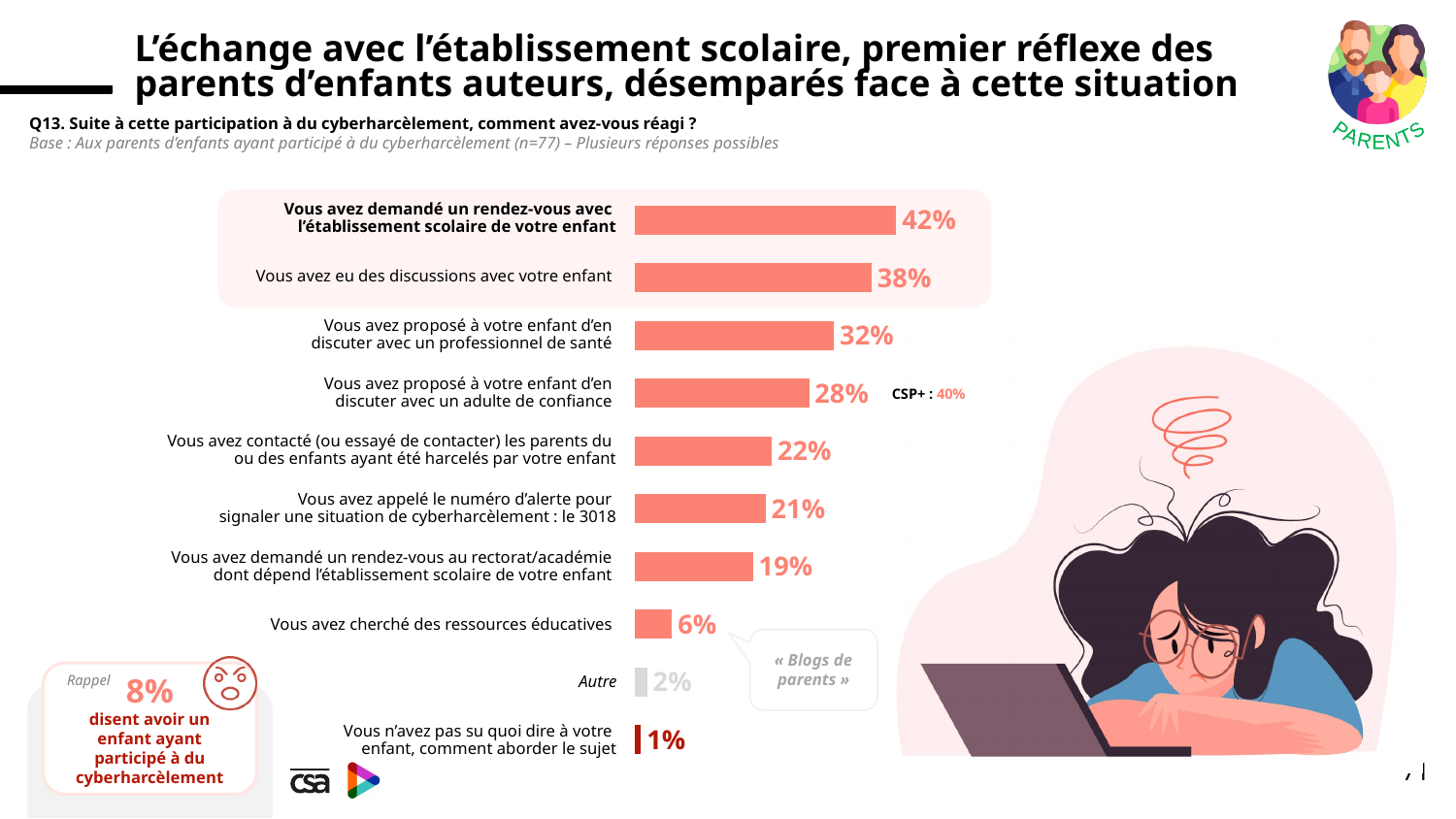
Which is larger: the value for "Vous avez proposé à votre enfant d'en discuter avec un professionnel de santé" or for "Vous avez proposé à votre enfant d'en discuter avec un adulte de confiance"? Vous avez proposé à votre enfant d'en discuter avec un professionnel de santé What is the value shown for "Vous avez eu des discussions avec votre enfant"? 38% Which response has the highest percentage in the chart? Vous avez demandé un rendez-vous avec l'établissement scolaire de votre enfant What is the difference in percentage points between "Vous avez demandé un rendez-vous avec l'établissement scolaire de votre enfant" (42%) and "Vous avez eu des discussions avec votre enfant" (38%)? 4 percentage points What CSP+ value is annotated next to the bar for "Vous avez proposé à votre enfant d'en discuter avec un adulte de confiance"? 40% What percentage of parents said they requested a meeting with their child's school ("Vous avez demandé un rendez-vous avec l'établissement scolaire de votre enfant")? 42% What type of chart is used on this slide? Bar chart Do the values in the chart increase or decrease from the top bar to the bottom bar? Decrease How many response categories are plotted in the bar chart? 10 What percentage is shown for "Vous avez appelé le numéro d'alerte pour signaler une situation de cyberharcèlement : le 3018"? 21% What value is shown for "Vous avez cherché des ressources éducatives"? 6% Which response has the lowest percentage in the chart? Vous n'avez pas su quoi dire à votre enfant, comment aborder le sujet